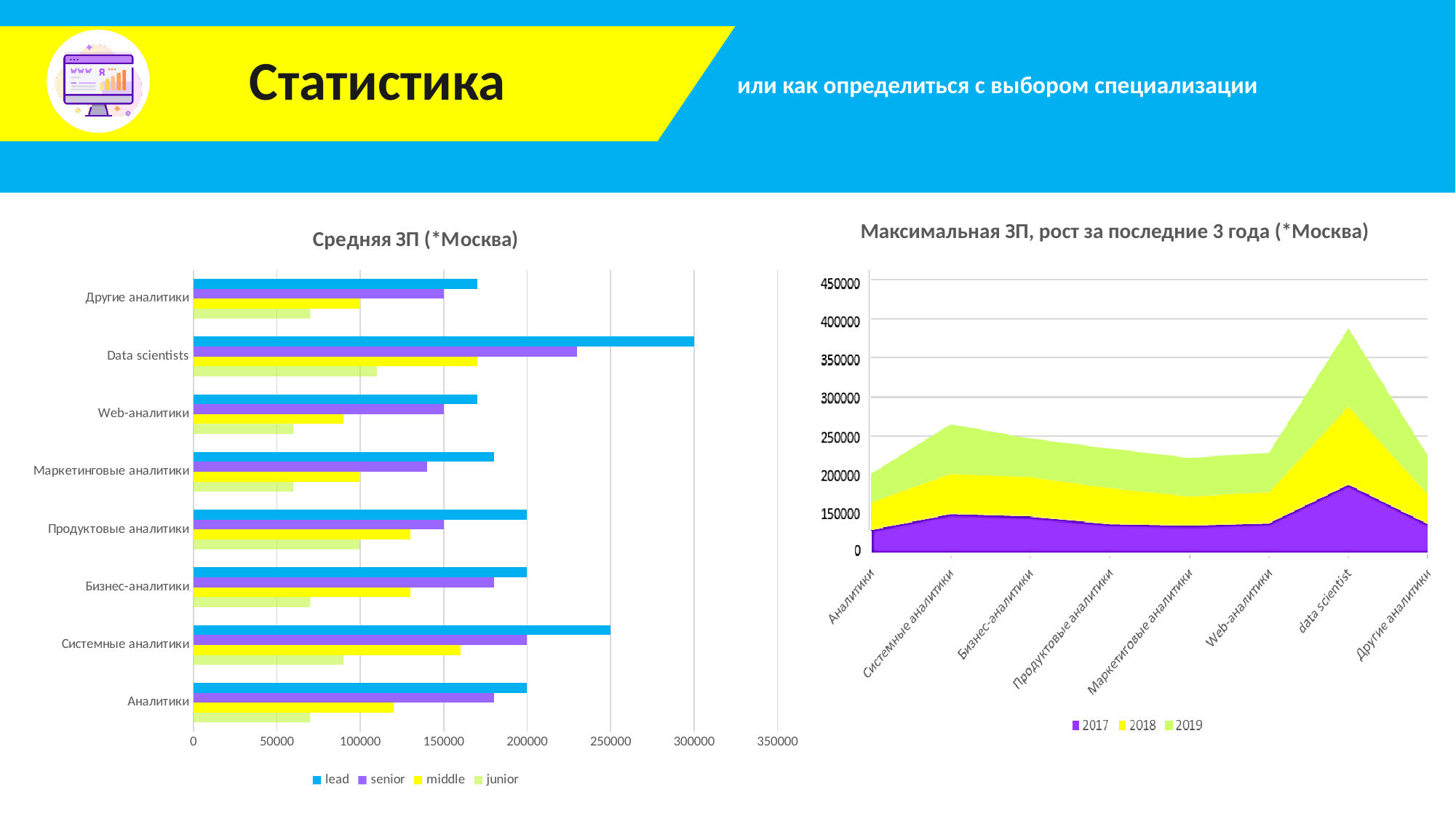
In the left chart "Средняя ЗП (*Москва)", what is the lead value for Data scientists? 300000 In the left chart "Средняя ЗП (*Москва)", is the senior value for Data scientists greater or less than 200000? greater In the right chart "Максимальная ЗП, рост за последние 3 года (*Москва)", which category has the highest stacked total? data scientist In the left chart "Средняя ЗП (*Москва)", which is larger: the lead value for Data scientists or the lead value for Системные аналитики? Data scientists What kind of chart is the left chart titled "Средняя ЗП (*Москва)"? bar chart In the left chart "Средняя ЗП (*Москва)", which category has the highest lead value? Data scientists In the left chart "Средняя ЗП (*Москва)", how many categories are shown on the vertical axis? 8 In the left chart "Средняя ЗП (*Москва)", what is the lead value for Системные аналитики? 250000 In the left chart "Средняя ЗП (*Москва)", is the junior value for Web-аналитики greater or less than 100000? less In the right chart "Максимальная ЗП, рост за последние 3 года (*Москва)", how many series does the legend list? 3 In the left chart "Средняя ЗП (*Москва)", how many series does the legend list? 4 What kind of chart is the right chart titled "Максимальная ЗП, рост за последние 3 года (*Москва)"? area chart